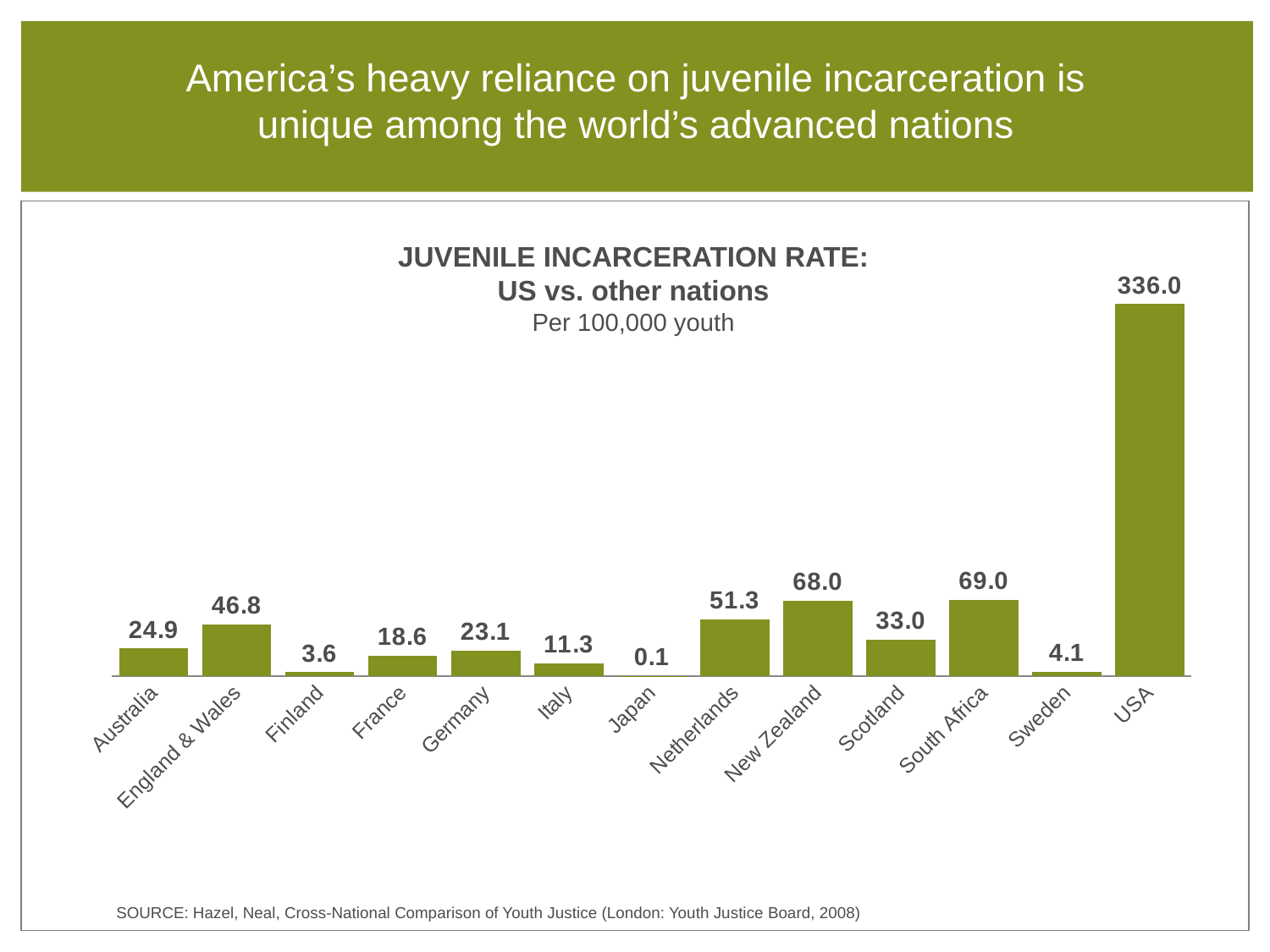
What is the difference between the juvenile incarceration rates of the USA and England & Wales? 289.2 Which country has the lowest juvenile incarceration rate? Japan How many countries are shown in the chart? 13 Which country has the highest juvenile incarceration rate? USA Which has a higher juvenile incarceration rate, Netherlands or Scotland? Netherlands What is the juvenile incarceration rate for Australia? 24.9 Which has a higher juvenile incarceration rate, Finland or Sweden? Sweden What is the difference between the juvenile incarceration rates of South Africa and New Zealand? 1.0 What kind of chart is shown on the slide? Bar chart What is the juvenile incarceration rate for Japan? 0.1 What unit is the juvenile incarceration rate expressed in, according to the chart subtitle? Per 100,000 youth What is the juvenile incarceration rate for the USA? 336.0